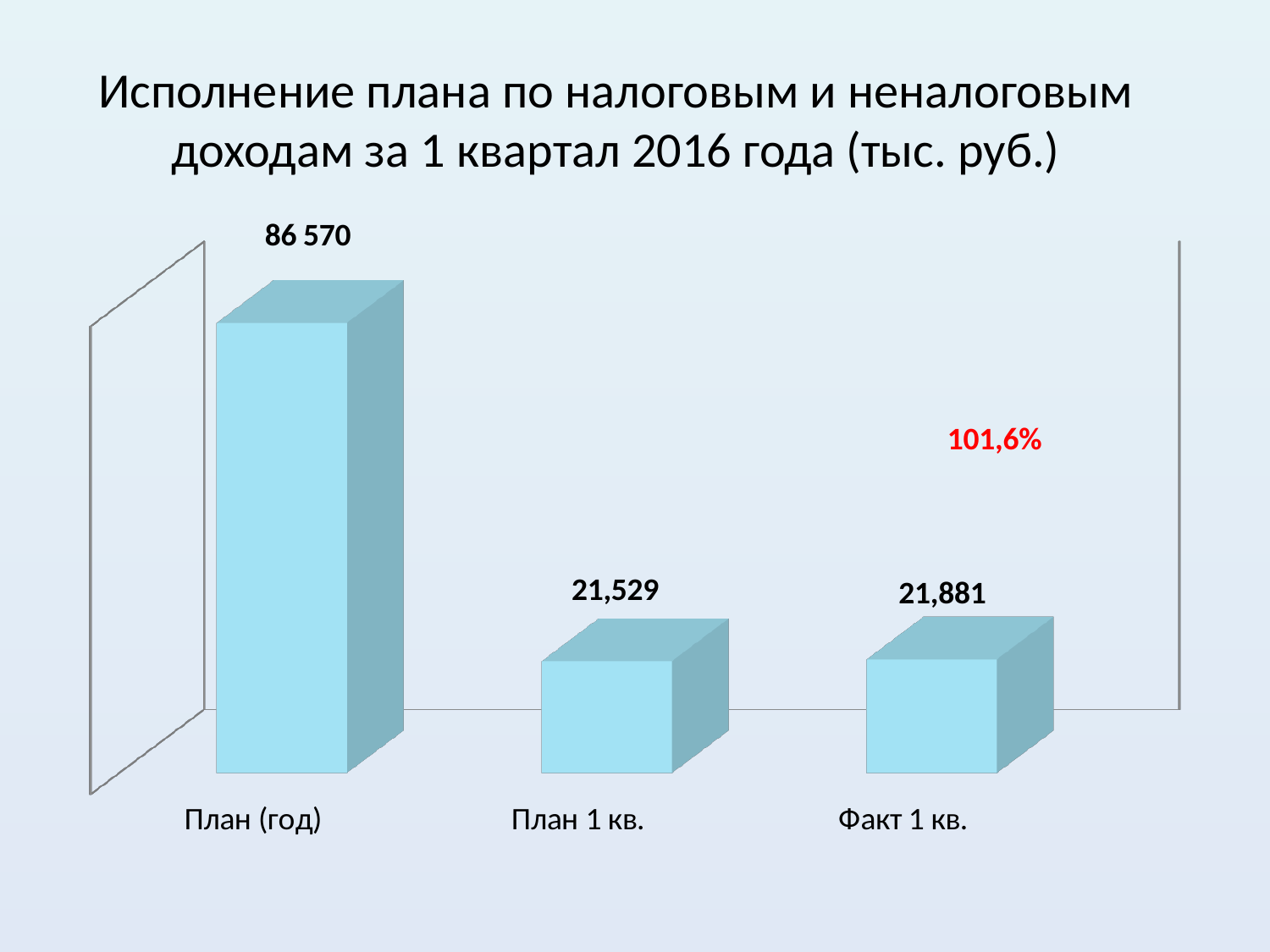
What is the difference between the values for Факт 1 кв. and План 1 кв.? 352 What is the title of the chart? Исполнение плана по налоговым и неналоговым доходам за 1 квартал 2016 года (тыс. руб.) What kind of chart is shown on the slide? Bar chart Which is larger, the value for Факт 1 кв. or the value for План 1 кв.? Факт 1 кв. How many categories are shown in the chart? 3 Which category has the lowest value? План 1 кв. What is the value for План 1 кв.? 21,529 Which category has the highest value? План (год) What is the value for План (год)? 86 570 What is the value for Факт 1 кв.? 21,881 What percentage is printed in red on the chart? 101,6%